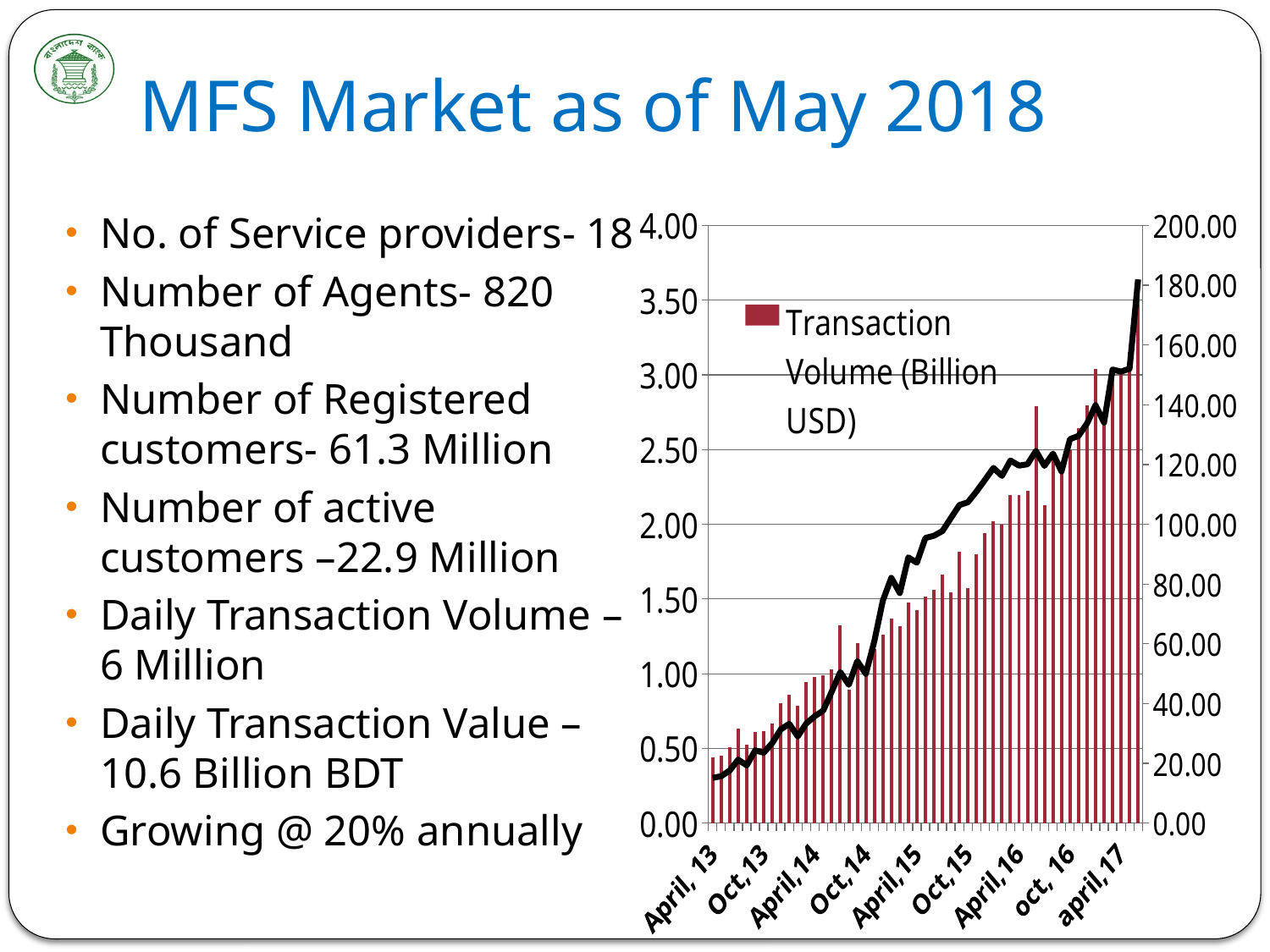
Is the transaction volume bar at April, 16 greater or less than 2.00? greater Is the transaction volume bar at Oct, 13 greater or less than 1.00? less Which labelled period on the x axis has the lowest transaction volume bars? April, 13 What kind of chart is shown on the slide? A bar chart with a line overlaid (combination chart) How many period labels are shown along the x axis of the chart? 9 What is the maximum value shown on the right-hand vertical axis of the chart? 200.00 Is the tallest transaction volume bar at the right end of the chart greater or less than 3.00? greater How many series does the chart legend list? 1 What is the name of the series shown in the chart legend? Transaction Volume (Billion USD) Do the transaction volume bars generally rise or fall from April, 13 to april, 17? Rise Which labelled period on the x axis has the highest transaction volume bars? april, 17